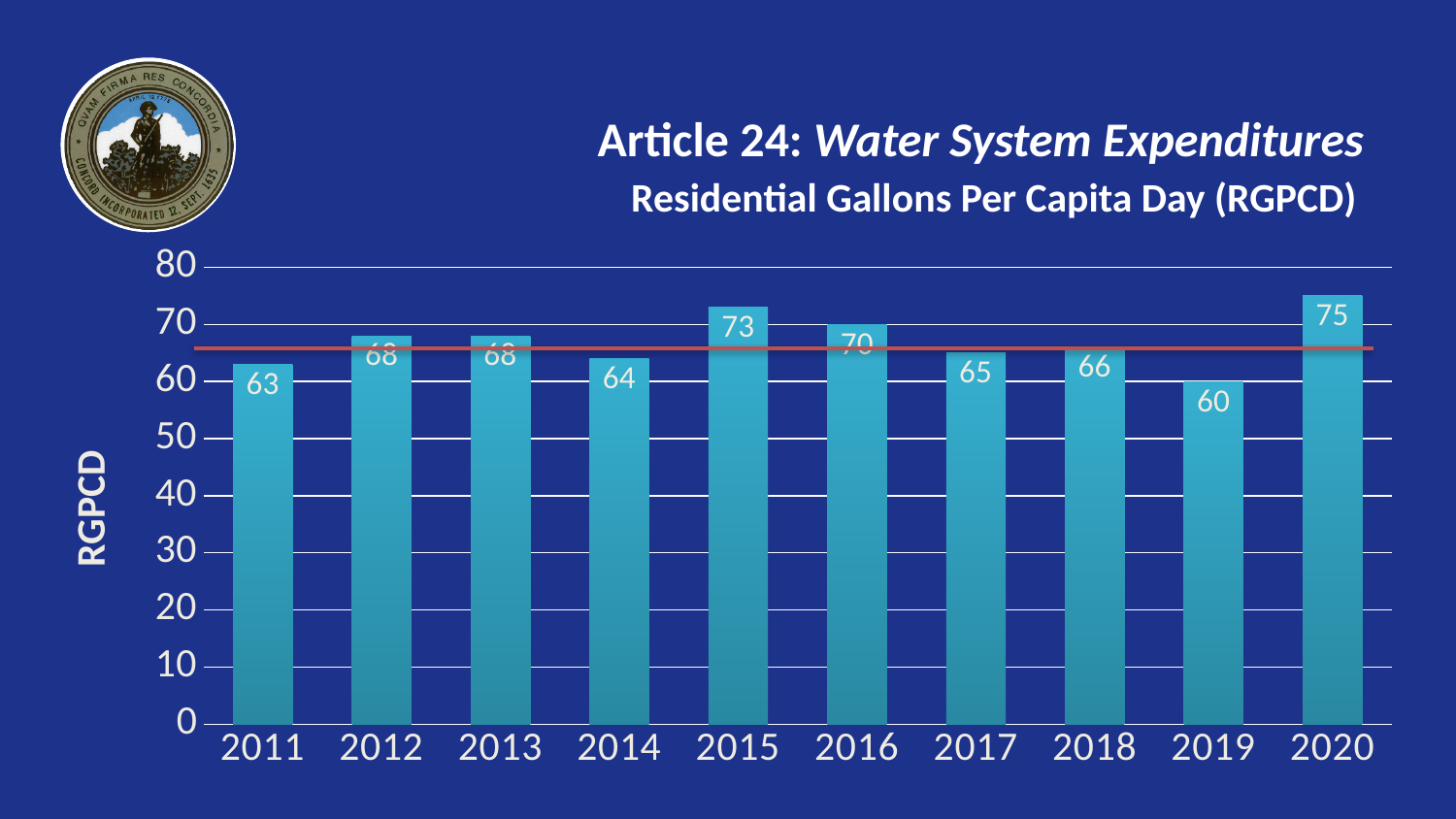
What kind of chart is shown on the slide? bar chart What is the difference between the RGPCD values for 2016 and 2014? 6 Is the RGPCD value for 2018 greater or less than 70? less Which year has the lowest RGPCD value? 2019 What is the RGPCD value for 2011? 63 Which year has a larger RGPCD value, 2015 or 2017? 2015 What is the difference between the RGPCD values for 2020 and 2019? 15 What is the RGPCD value for 2015? 73 How many years are shown on the x axis of the chart? 10 What is the label on the vertical axis of the chart? RGPCD What is the RGPCD value for 2019? 60 Which year has the highest RGPCD value? 2020